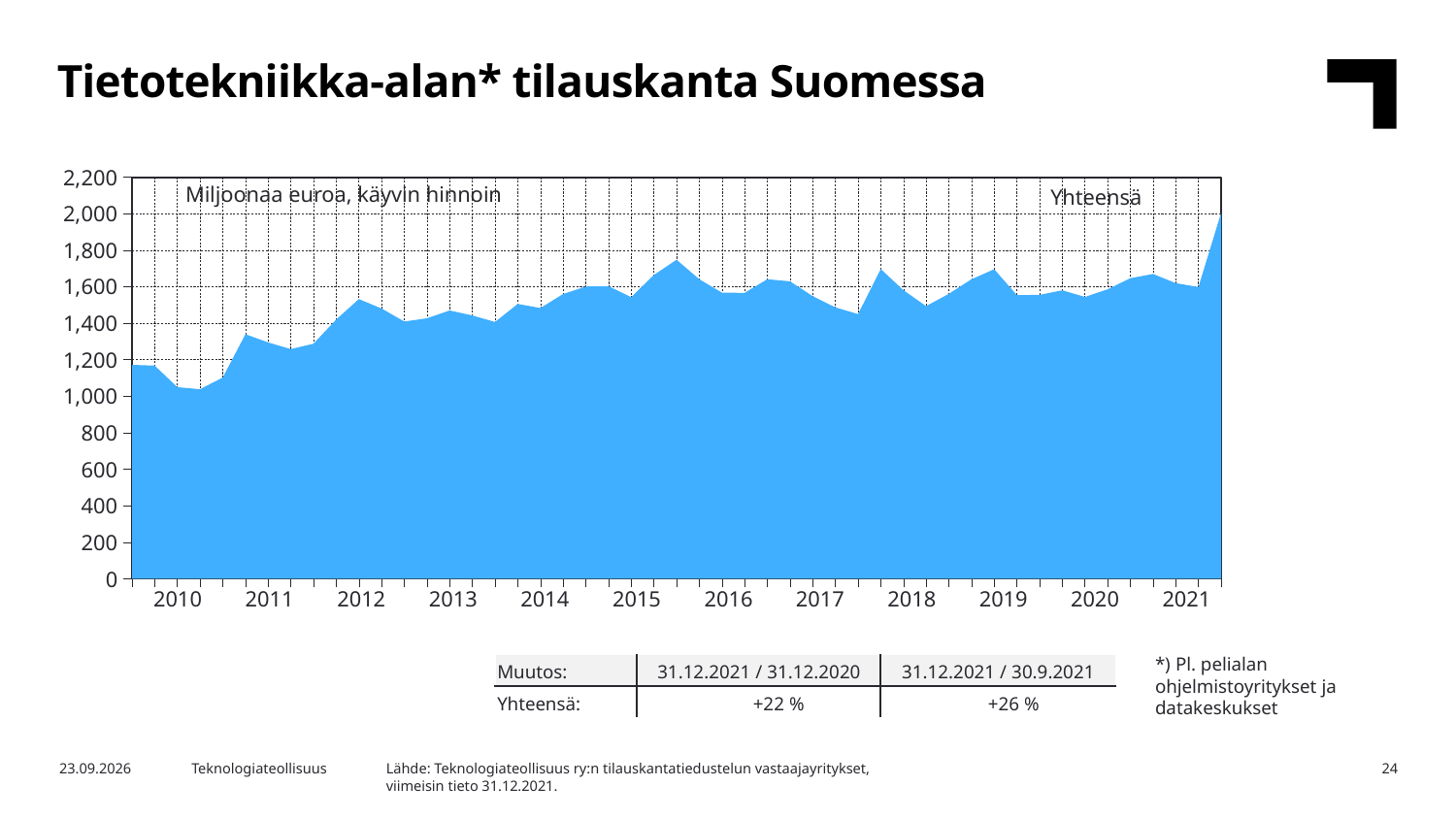
What is the highest value shown on the y axis of the chart? 2,200 What is the title of the slide's chart? Tietotekniikka-alan* tilauskanta Suomessa In which year does the chart reach its highest value? 2021 According to the table below the chart, what is the change (Muutos) for Yhteensä between 31.12.2020 and 31.12.2021? +22 % Is the lowest value in 2010 greater or less than 1,200? less Is the peak value in 2015 greater or less than 1,600? greater Overall, does the order backlog rise or fall from 2010 to 2021? rise What unit is stated in the label at the top left of the chart? Miljoonaa euroa, käyvin hinnoin Is the value at the end of 2021 greater or less than 1,800? greater How many years are labelled on the x axis of the chart? 12 In which year does the chart reach its lowest value? 2010 What kind of chart is shown on the slide? Area chart